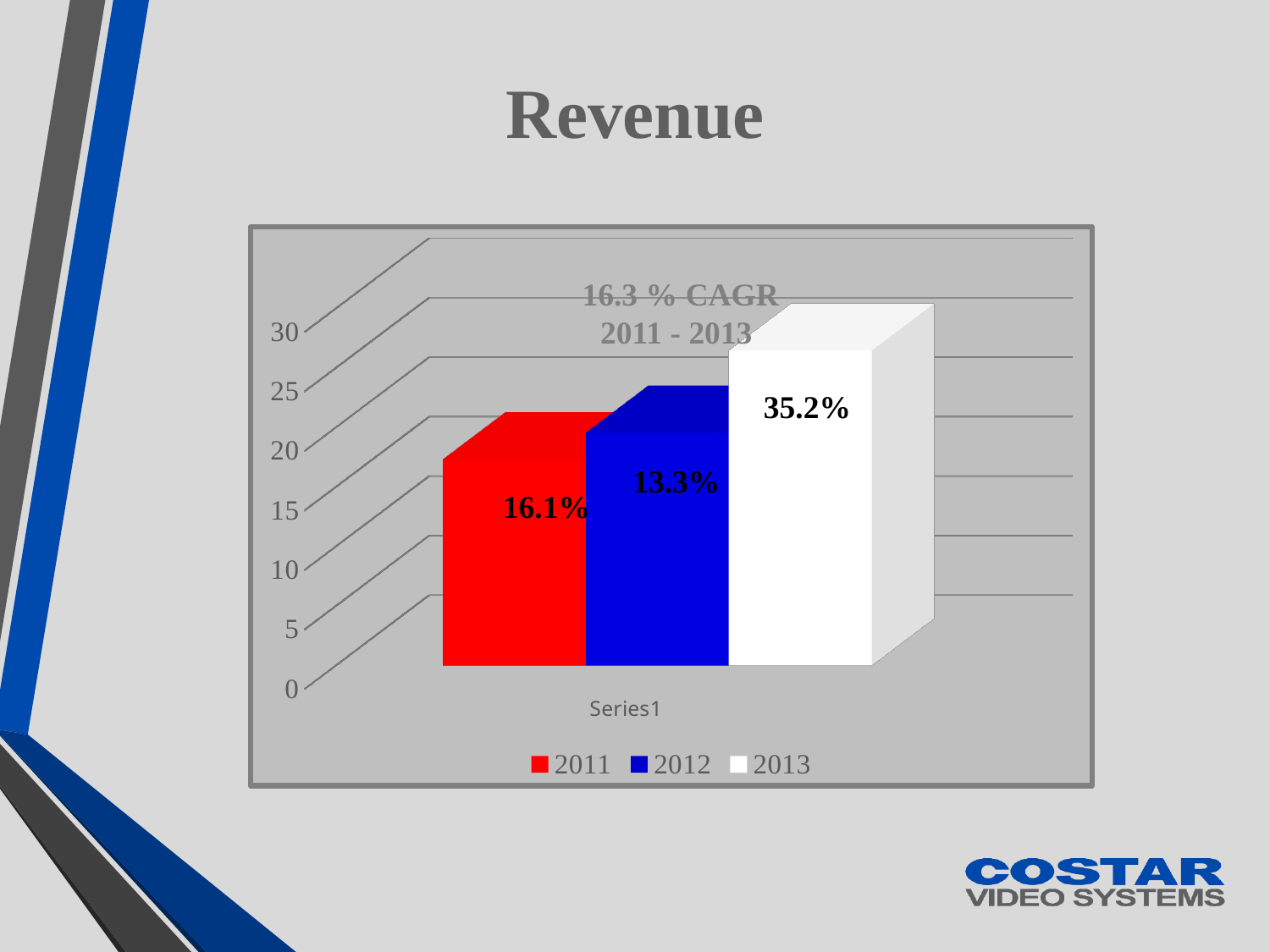
What CAGR figure is printed on the chart? 16.3 % CAGR What type of chart is shown on the slide? bar chart What label is printed on the 2011 bar? 16.1% Which year has the shortest bar? 2011 Which year has the tallest bar? 2013 How many series does the chart legend list? 3 Is the height of the 2013 bar greater or less than 25 on the axis? greater Which bar is taller, 2011 or 2013? 2013 Is the height of the 2011 bar greater or less than 20 on the axis? less What label is printed on the 2012 bar? 13.3% What label is printed on the 2013 bar? 35.2% What colour is the 2012 bar? blue